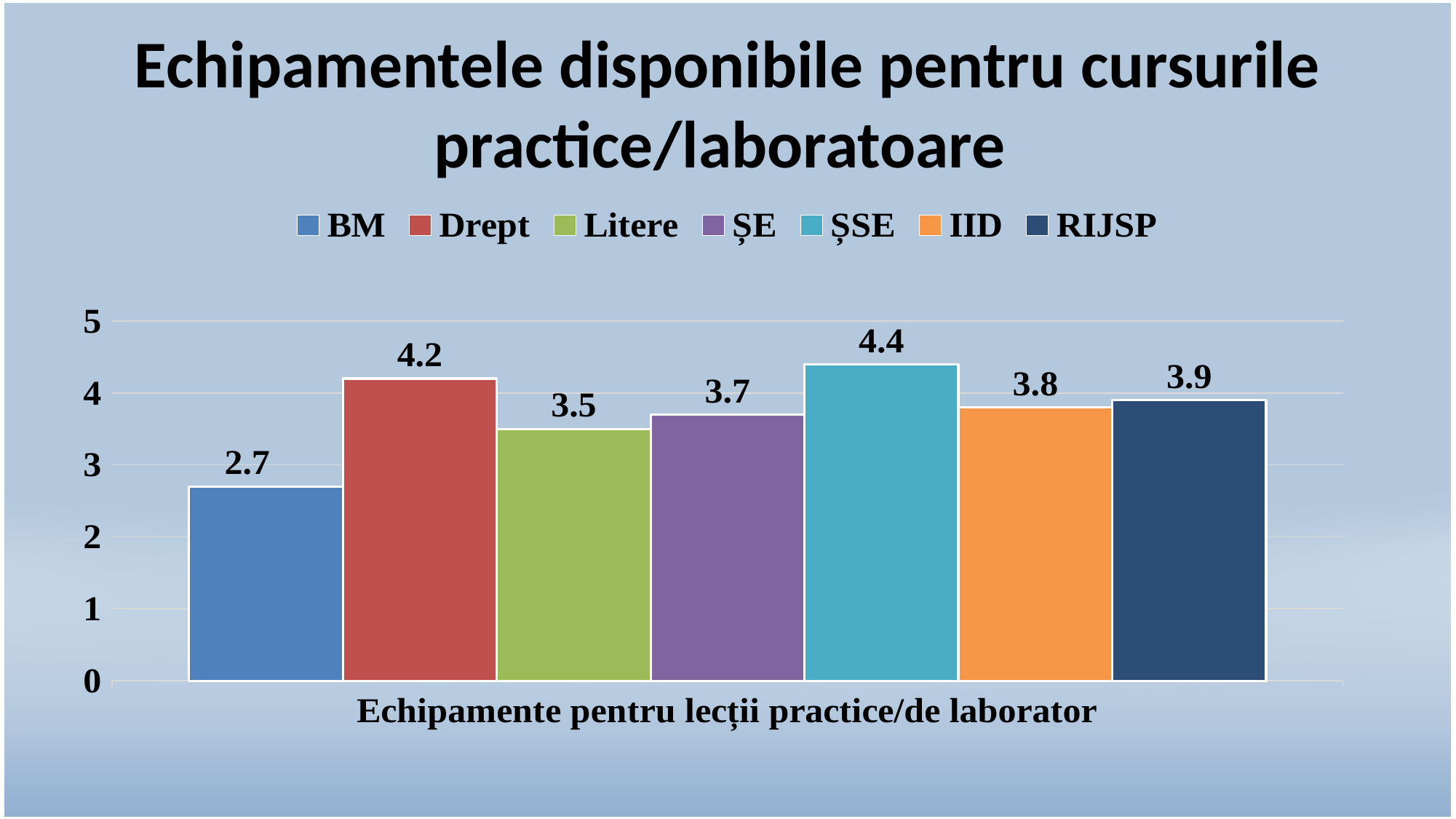
Which is larger, the value for ȘE or the value for RIJSP? RIJSP What colour is the bar for Litere? green Is the value for BM greater or less than 3? less What is the value for ȘSE? 4.4 What is the label on the horizontal axis of the chart? Echipamente pentru lecții practice/de laborator What is the difference between the values for Drept and Litere? 0.7 How many series does the legend list? 7 What is the value for BM? 2.7 What kind of chart is shown on the slide? bar chart Which series has the highest value? ȘSE What is the value for IID? 3.8 Which series has the lowest value? BM